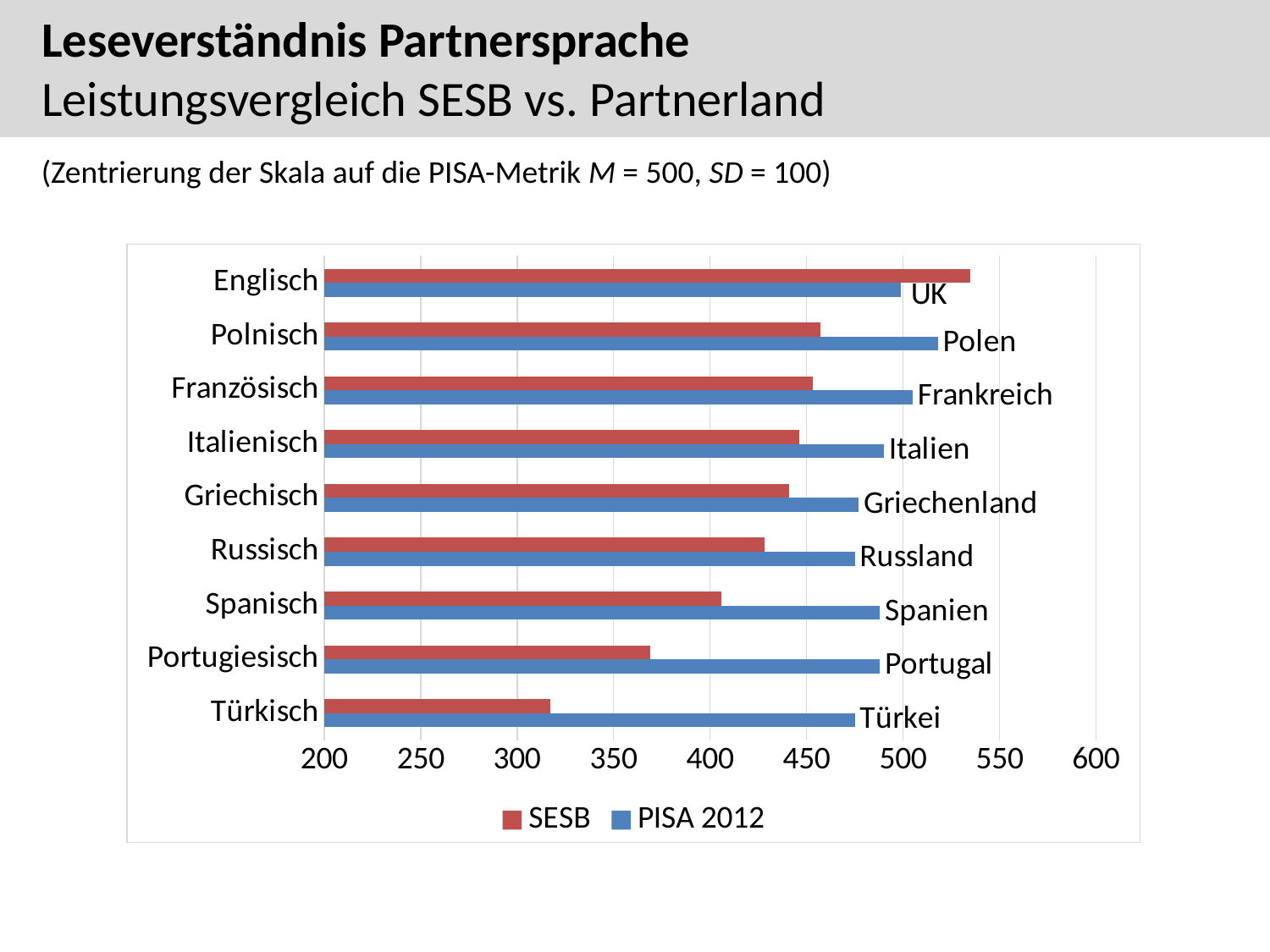
For Englisch, which is larger: the SESB value or the PISA 2012 value? SESB Which language has the highest SESB value? Englisch How many language categories are shown on the y axis? 9 What kind of chart is shown on the slide? bar chart Is the SESB value for Russisch greater or less than 400? greater Which country label is printed next to the PISA 2012 bar for Polnisch? Polen Is the SESB value for Türkisch greater or less than 350? less For Polnisch, which is larger: the SESB value or the PISA 2012 value? PISA 2012 Is the SESB value for Portugiesisch greater or less than 400? less How many series does the legend list? 2 Which language has the lowest SESB value? Türkisch